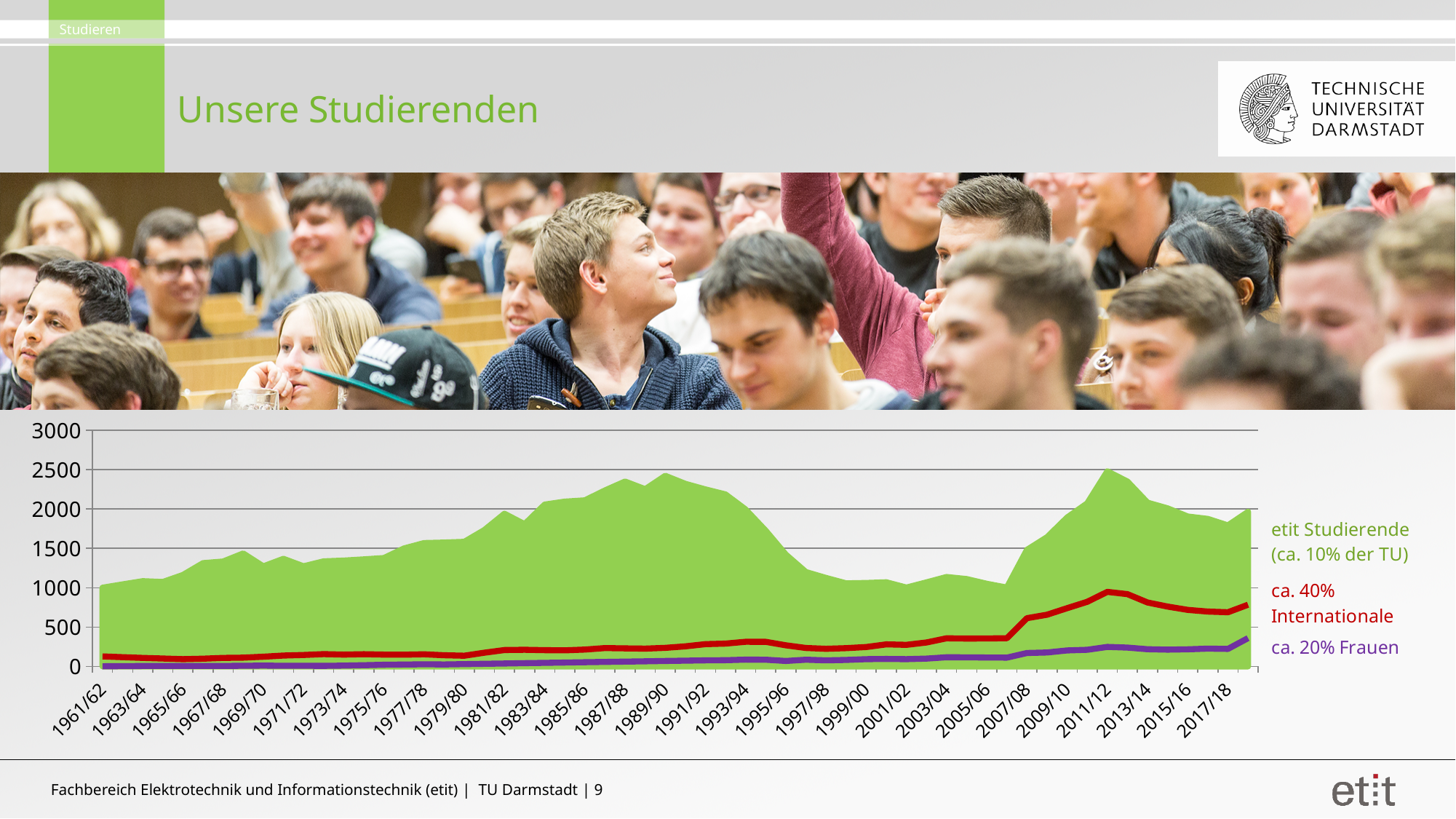
Which is larger for etit Studierende: the value in 1989/90 or the value in 1999/00? 1989/90 What is the title of the slide containing the chart? Unsere Studierenden Which series has the highest values throughout the chart? etit Studierende (ca. 10% der TU) Which series has the lowest values throughout the chart? ca. 20% Frauen Do the Internationale values rise or fall between 2005/06 and 2011/12? rise Do the etit Studierende values rise or fall between 1995/96 and 2005/06? fall How many series does the chart's legend list? 3 Is the value for Frauen in 2017/18 greater or less than 500? less Is the value for Internationale in 2011/12 greater or less than 500? greater Is the value for etit Studierende in 1961/62 greater or less than 1500? less What kind of chart is shown on the slide? area chart with line series